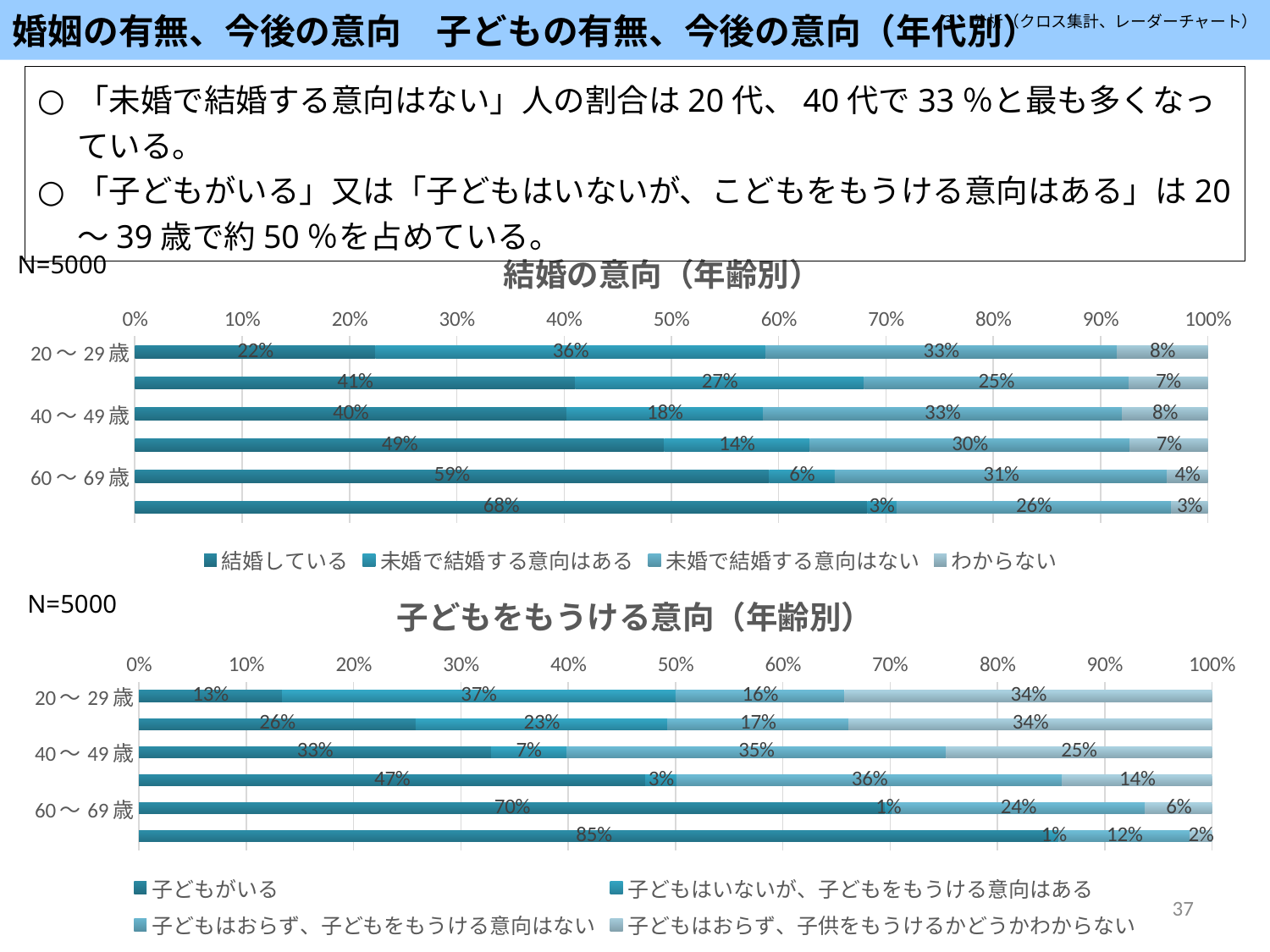
In the chart titled 結婚の意向（年齢別）, how many series does the legend list? 4 In the chart titled 子どもをもうける意向（年齢別）, what is the value of 子どもがいる for 20～29歳? 13% In the chart titled 結婚の意向（年齢別）, among the labeled age groups 20～29歳, 40～49歳 and 60～69歳, which has the highest value for 結婚している? 60～69歳 What kind of chart is 子どもをもうける意向（年齢別）? Stacked horizontal bar chart In the chart titled 子どもをもうける意向（年齢別）, which is larger for 20～29歳: 子どもがいる or 子どもはいないが、子どもをもうける意向はある? 子どもはいないが、子どもをもうける意向はある In the chart titled 子どもをもうける意向（年齢別）, what is the value of 子どもがいる for 60～69歳? 70% In the chart titled 結婚の意向（年齢別）, what is the difference between the 結婚している values for 60～69歳 and 20～29歳? 37% In the chart titled 結婚の意向（年齢別）, what is the value of 未婚で結婚する意向はある for 40～49歳? 18% In the chart titled 結婚の意向（年齢別）, what is the value of 結婚している for 20～29歳? 22% In the chart titled 結婚の意向（年齢別）, what is the value of 未婚で結婚する意向はない for 60～69歳? 31% In the chart titled 子どもをもうける意向（年齢別）, what is the value of 子どもはおらず、子どもをもうける意向はない for 40～49歳? 35% In the chart titled 子どもをもうける意向（年齢別）, what is the combined value of 子どもがいる and 子どもはいないが、子どもをもうける意向はある for 20～29歳? 50%